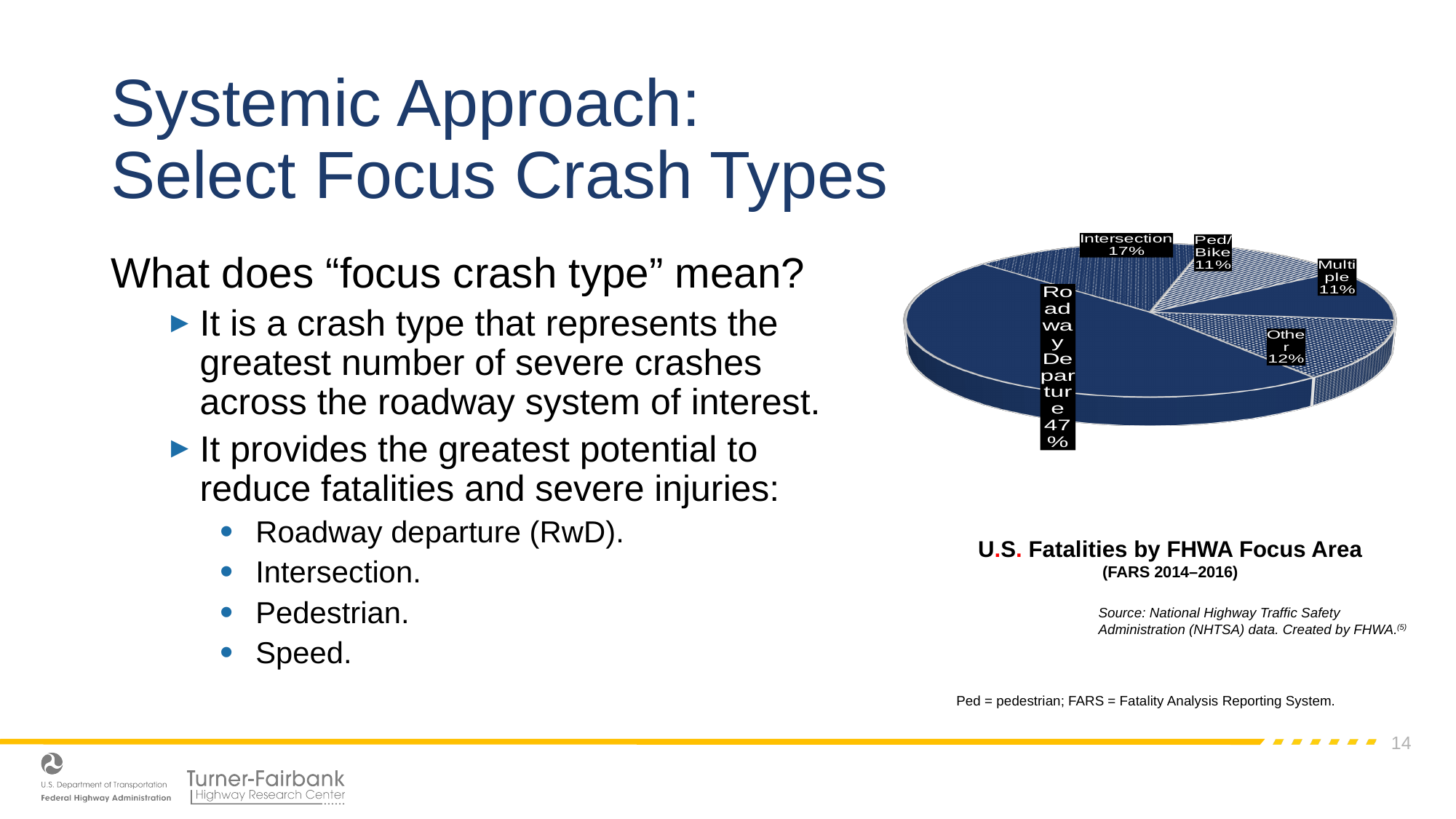
What is the title of the chart? U.S. Fatalities by FHWA Focus Area (FARS 2014–2016) What share of U.S. fatalities is attributed to Other? 12% What share of U.S. fatalities is attributed to Ped/Bike? 11% What share of U.S. fatalities is attributed to Roadway Departure? 47% What is the difference in percentage points between the Roadway Departure and Intersection shares? 30 Which is larger, the share for Other or the share for Intersection? Intersection Which focus area has the largest share of fatalities? Roadway Departure What kind of chart is shown on the slide? Pie chart What share of U.S. fatalities is attributed to Multiple? 11% What is the combined share of the Ped/Bike and Multiple slices? 22% What share of U.S. fatalities is attributed to Intersection? 17% How many slices does the pie chart have? 5